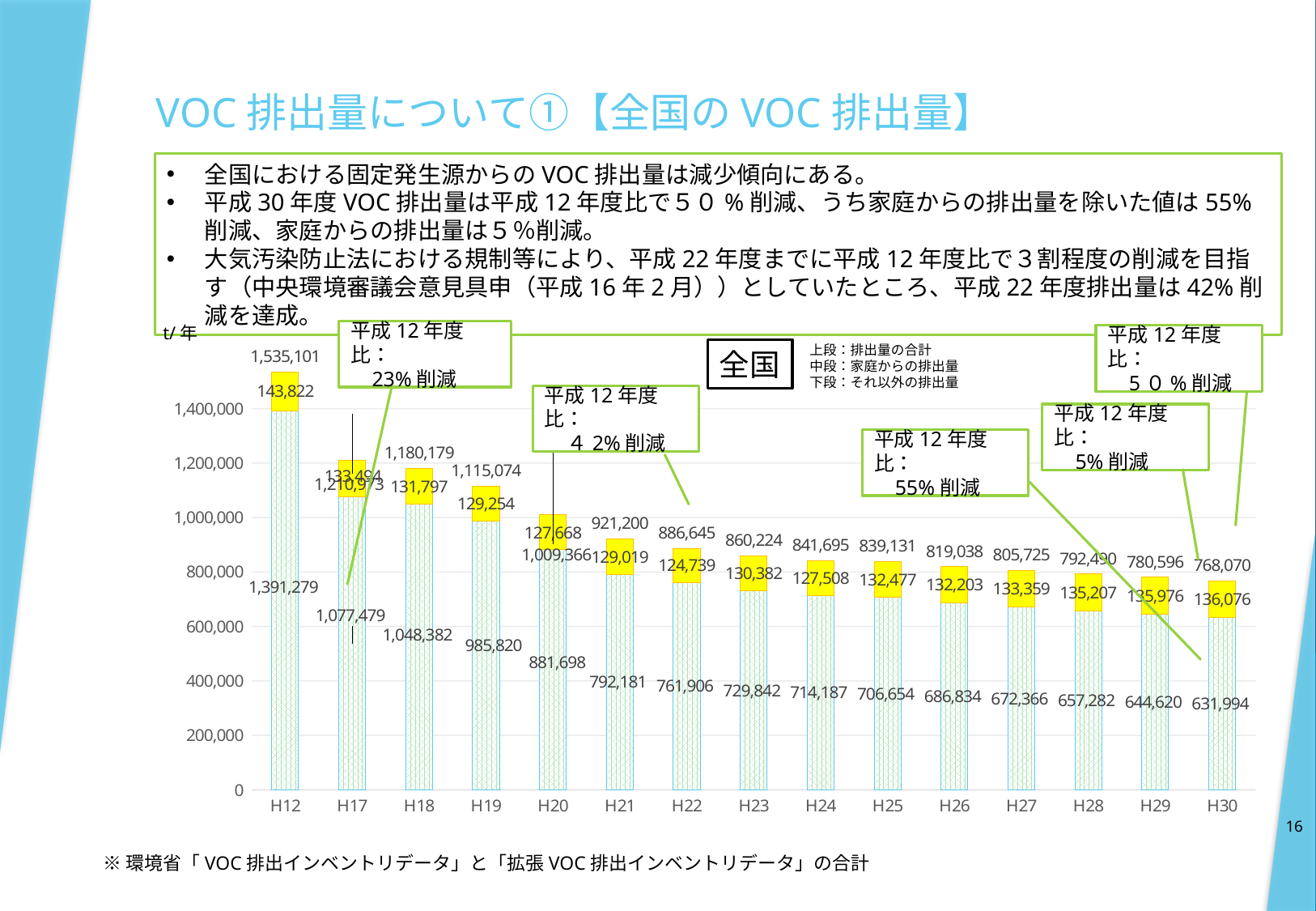
What unit is shown on the y axis of the chart? t/年 What kind of chart is shown on the slide? stacked bar chart What is the household emission value (middle label) shown for H30? 136,076 What is the total VOC emission value shown for H12? 1,535,101 What is the non-household emission value (bottom label) shown for H20? 881,698 Do the total VOC emissions rise or fall from H12 to H30? fall Which is larger, the total emission for H21 or the total emission for H22? H21 Which year has the lowest total VOC emission? H30 Is the total emission for H25 greater or less than 1,000,000? less What is the difference between the total emission for H12 and the total emission for H30? 767,031 Which year has the highest total VOC emission? H12 How many years (categories) are shown on the x axis? 15